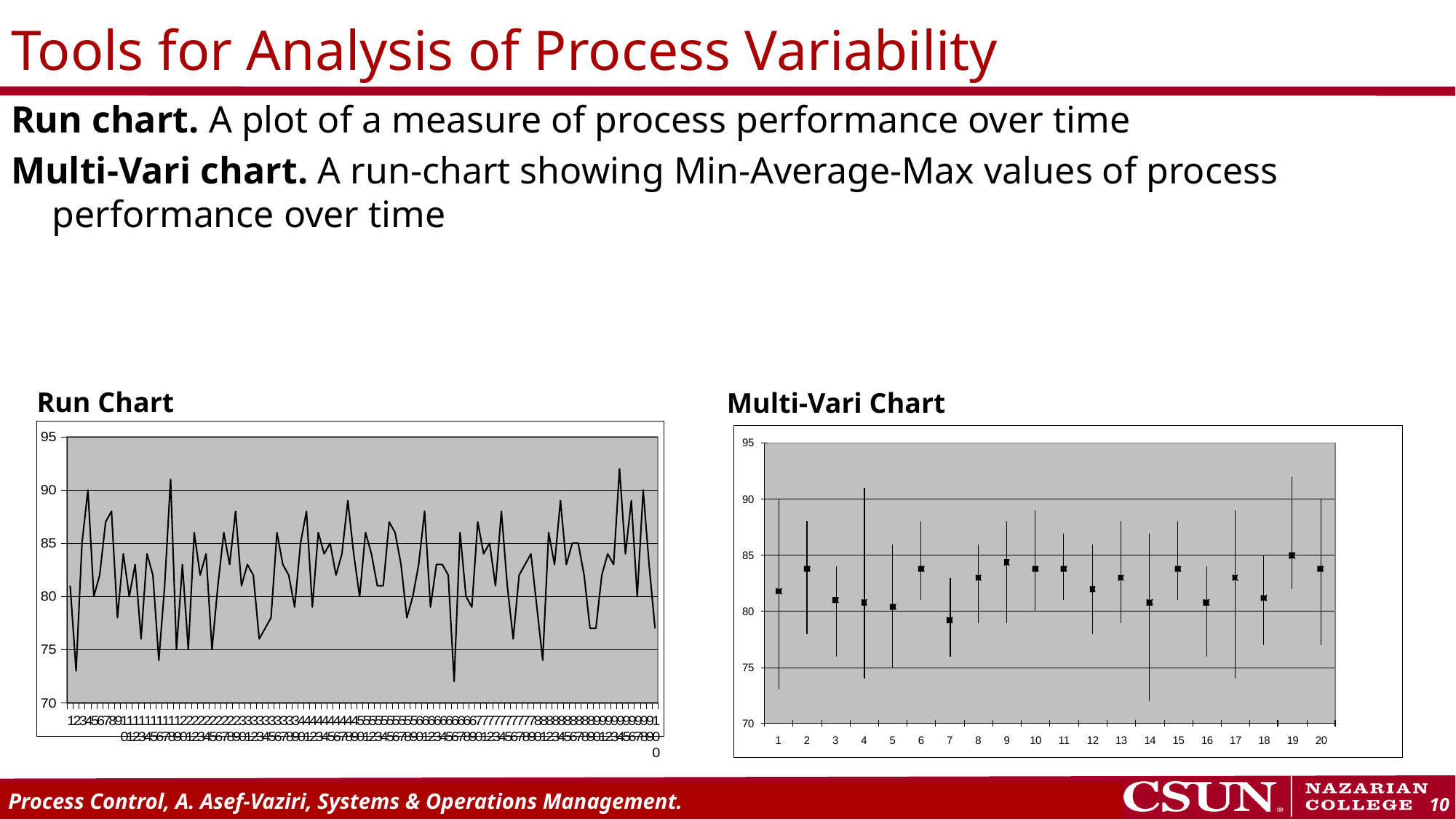
In the Multi-Vari Chart, which period has the lowest average marker? 7 What kind of chart is the Run Chart on the left of the slide? line chart In the Multi-Vari Chart, is the average value for period 9 greater or less than 80? greater What is the highest value shown on the y axis of the Run Chart? 95 In the Multi-Vari Chart, is the average value for period 7 greater or less than 80? less What is the lowest value shown on the y axis of the Multi-Vari Chart? 70 In the Multi-Vari Chart, is the minimum value for period 14 greater or less than 75? less In the Multi-Vari Chart, how many time periods are shown on the x axis? 20 In the Multi-Vari Chart, is the average for period 9 larger or smaller than the average for period 7? larger